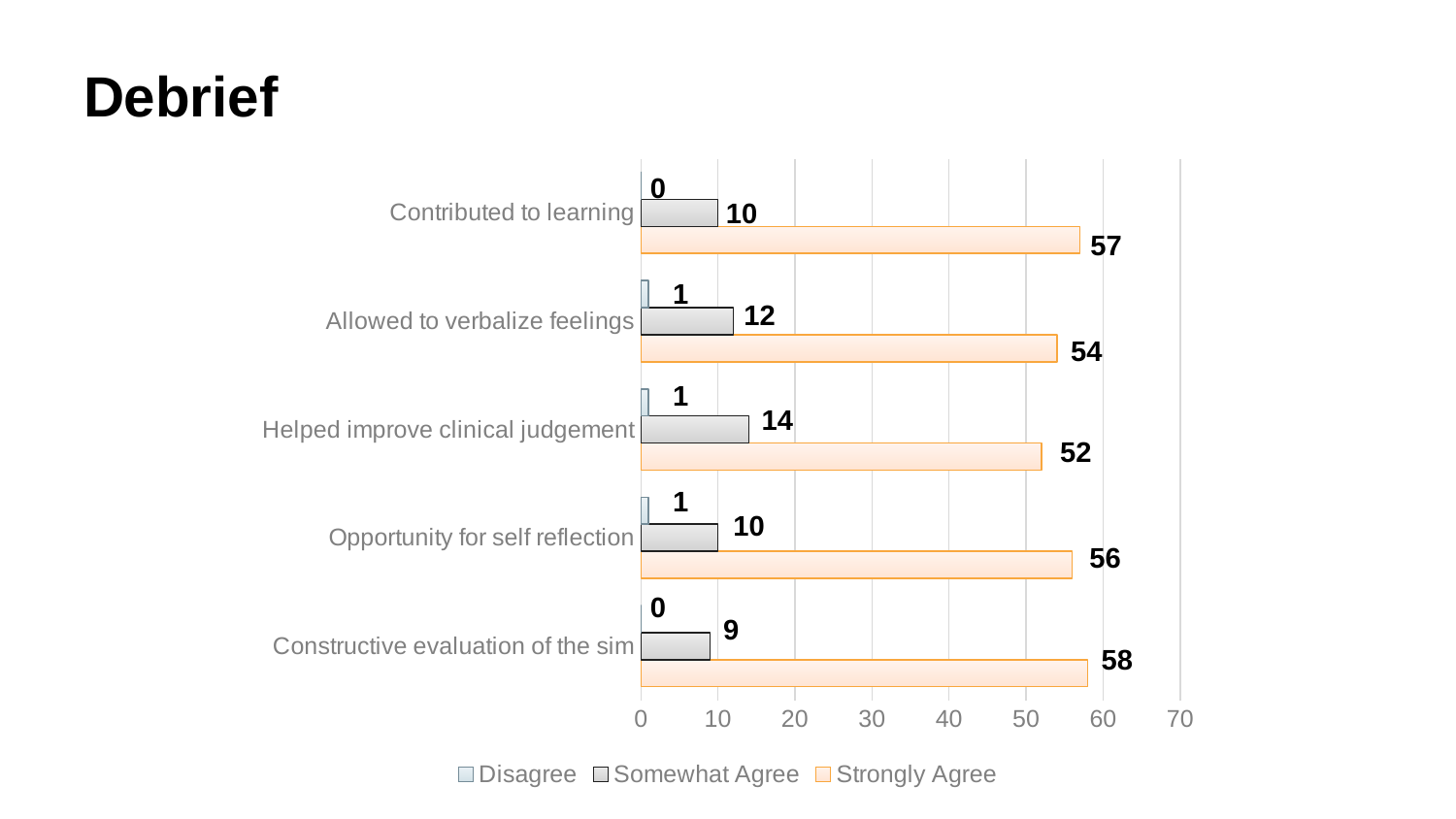
What kind of chart is shown on the slide? Bar chart What is the title of the slide? Debrief How many categories are shown on the chart? 5 Which category has the lowest Strongly Agree value? Helped improve clinical judgement What is the Strongly Agree value for Contributed to learning? 57 What is the difference between the Strongly Agree values for Constructive evaluation of the sim and Helped improve clinical judgement? 6 Which category has the highest Strongly Agree value? Constructive evaluation of the sim Which is larger: the Somewhat Agree value for Allowed to verbalize feelings or for Opportunity for self reflection? Allowed to verbalize feelings What is the Disagree value for Allowed to verbalize feelings? 1 Which category has the lowest Somewhat Agree value? Constructive evaluation of the sim How many series does the legend list? 3 What is the Somewhat Agree value for Helped improve clinical judgement? 14